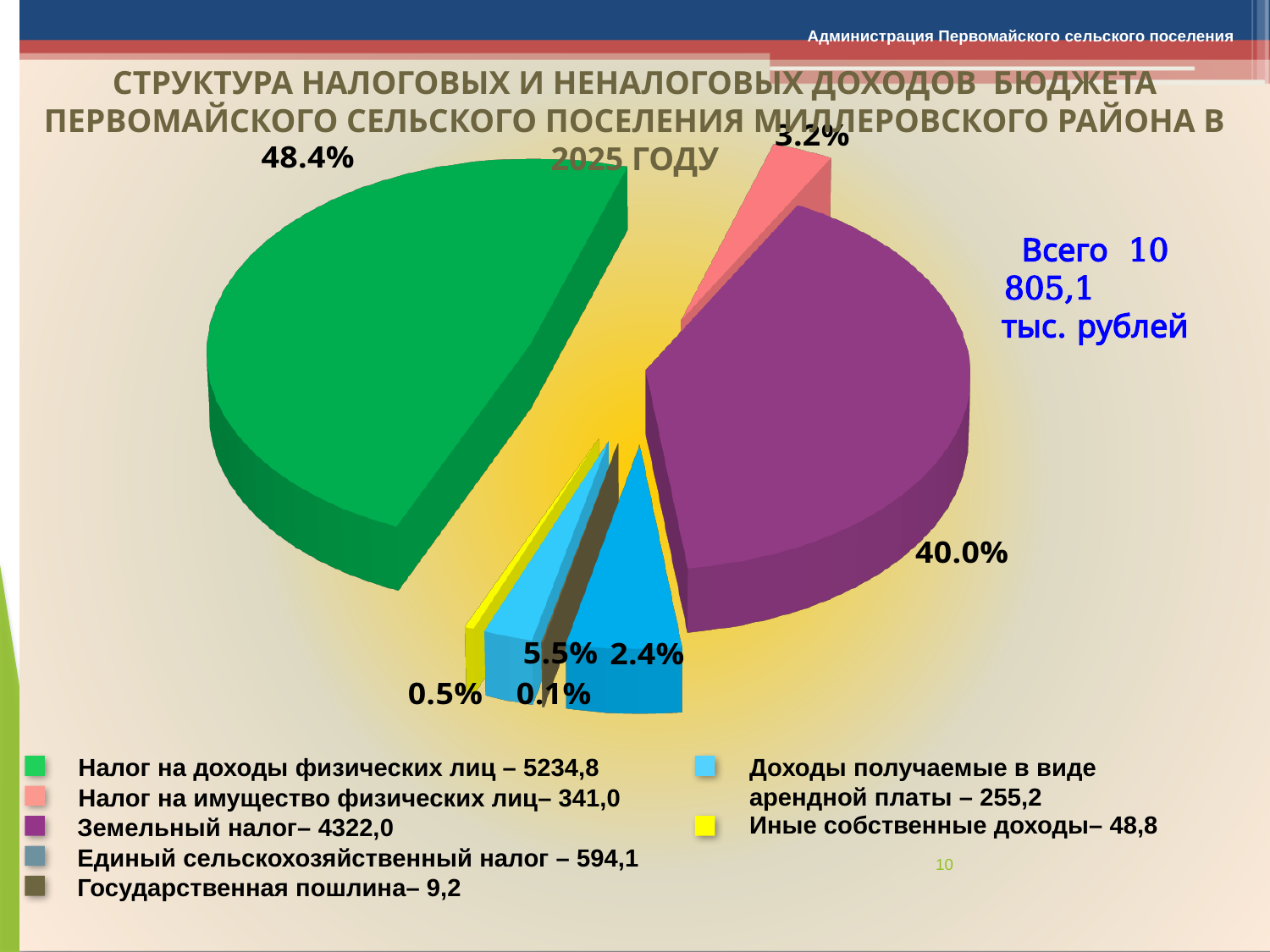
How many categories does the legend of the pie chart list? 7 What share of the pie does Доходы получаемые в виде арендной платы have? 2.4% What share of the pie does Налог на доходы физических лиц have? 48.4% Which category has the smallest slice of the pie? Государственная пошлина What value does the legend give for Иные собственные доходы? 48,8 What kind of chart is shown on the slide? pie chart Which is larger: the share of Налог на имущество физических лиц or the share of Единый сельскохозяйственный налог? Единый сельскохозяйственный налог What share of the pie does Земельный налог have? 40.0% What value does the legend give for Земельный налог? 4322,0 Which category has the largest slice of the pie? Налог на доходы физических лиц What total amount is stated next to the pie chart? 10 805,1 тыс. рублей By how many percentage points does the share of Налог на доходы физических лиц exceed the share of Земельный налог? 8.4